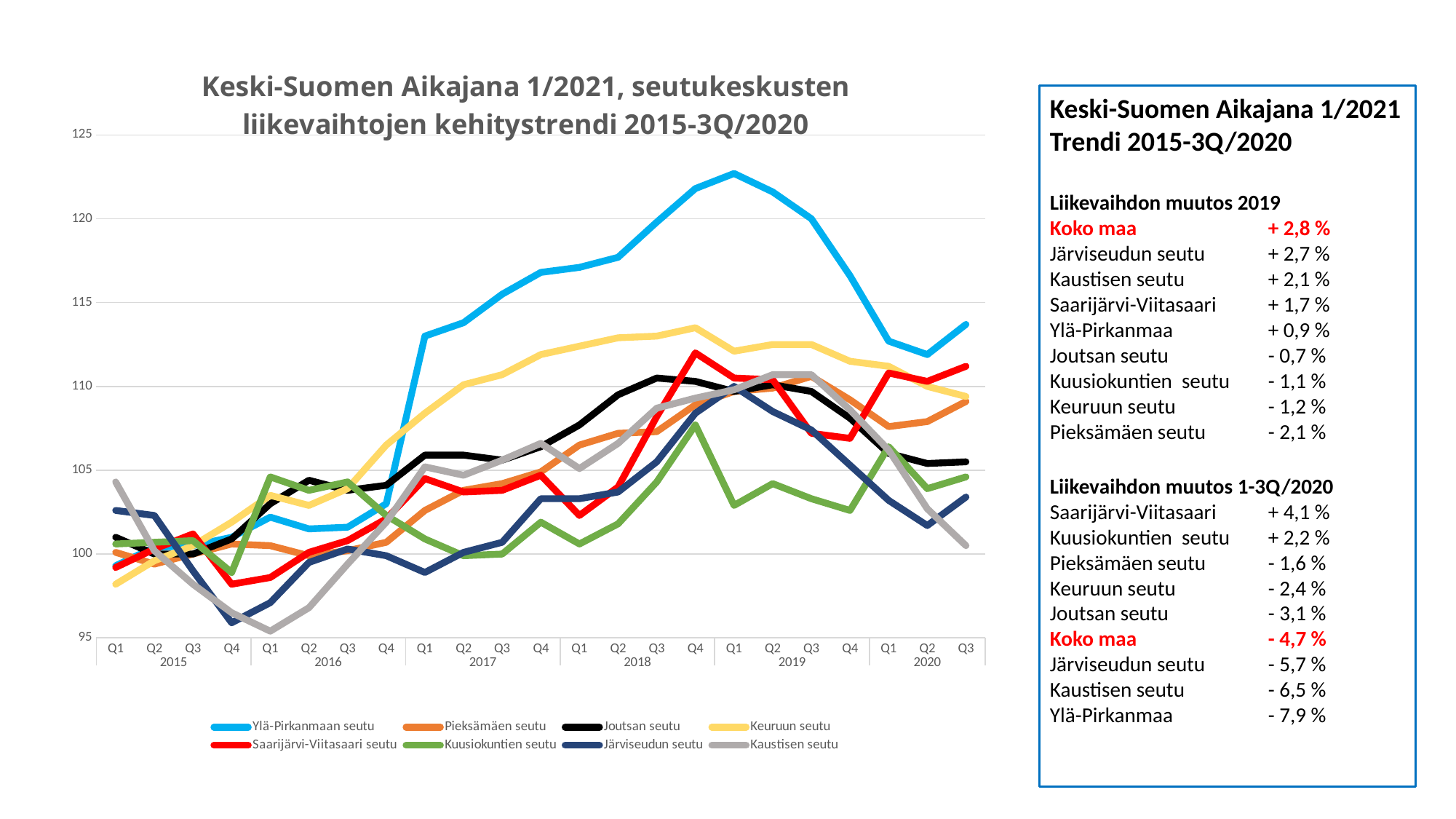
In Q3 2020, which is larger: the value for Saarijärvi-Viitasaari seutu or the value for Kaustisen seutu? Saarijärvi-Viitasaari seutu Does the value for Ylä-Pirkanmaan seutu rise or fall from Q1 2019 to Q2 2020? Fall What kind of chart is shown on the slide? Line chart Which series has the lowest value in Q1 2016? Kaustisen seutu How many quarterly points are plotted along the x axis of the chart? 23 How many series does the chart legend list? 8 Is the value for Kaustisen seutu in Q1 2016 greater or less than 100? less Which series has the highest value in Q1 2019? Ylä-Pirkanmaan seutu Is the value for Keuruun seutu in Q4 2018 greater or less than 110? greater Is the value for Ylä-Pirkanmaan seutu in Q1 2019 greater or less than 120? greater What is the title of the chart? Keski-Suomen Aikajana 1/2021, seutukeskusten liikevaihtojen kehitystrendi 2015-3Q/2020